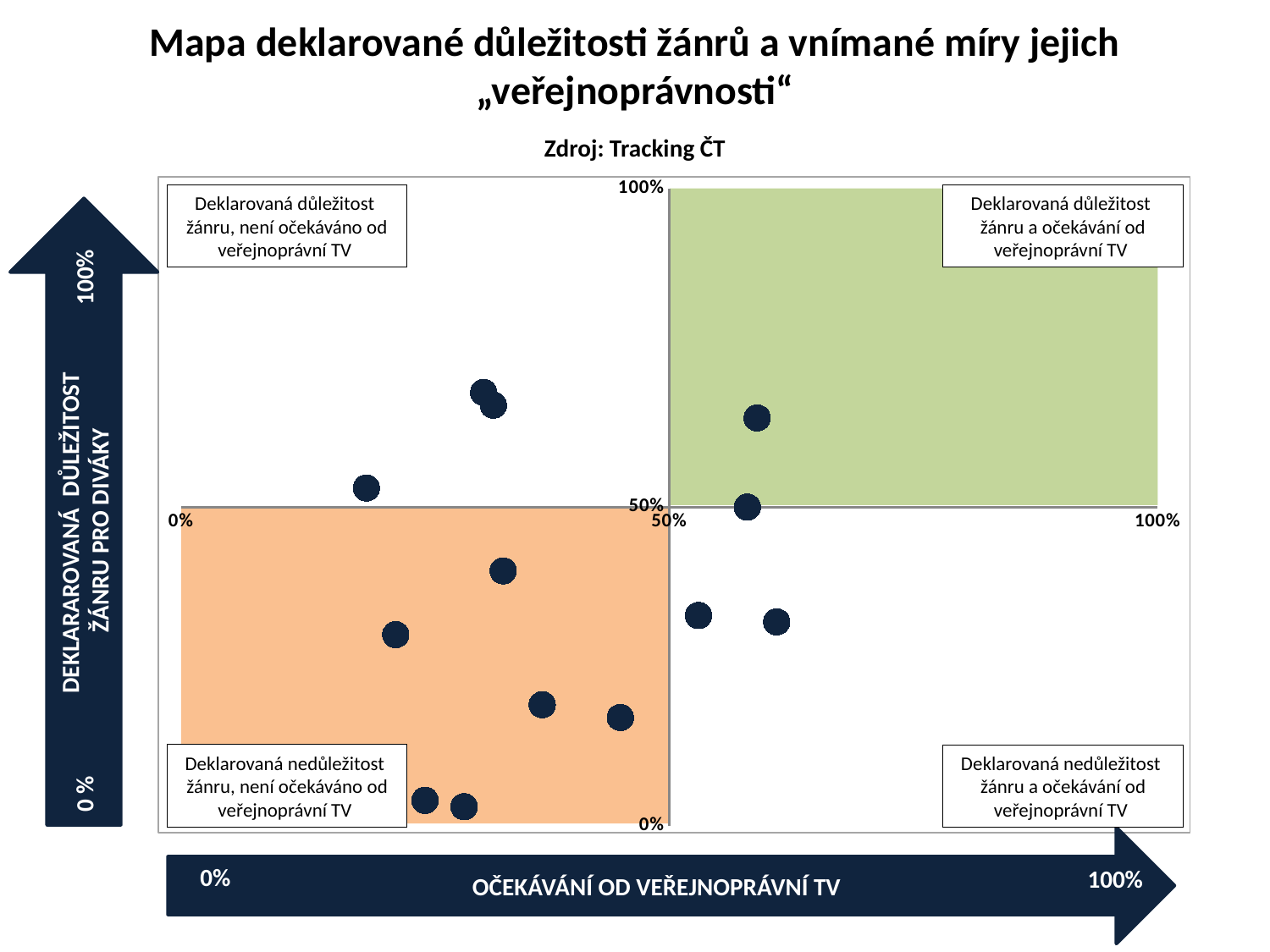
How many data points lie in the upper-left quadrant (above 50% importance, below 50% expectation)? 3 How many data points lie in the orange (lower-left) quadrant of the chart? 6 What kind of chart is shown on the slide? scatter plot What source is cited for the chart? Tracking ČT What is the label of the horizontal axis? OČEKÁVÁNÍ OD VEŘEJNOPRÁVNÍ TV How many data points are plotted on the chart? 13 What is the title of the chart? Mapa deklarované důležitosti žánrů a vnímané míry jejich „veřejnoprávnosti“ What value marks the midpoint of both axes where the quadrants divide? 50% What is the maximum value shown on the vertical axis? 100%